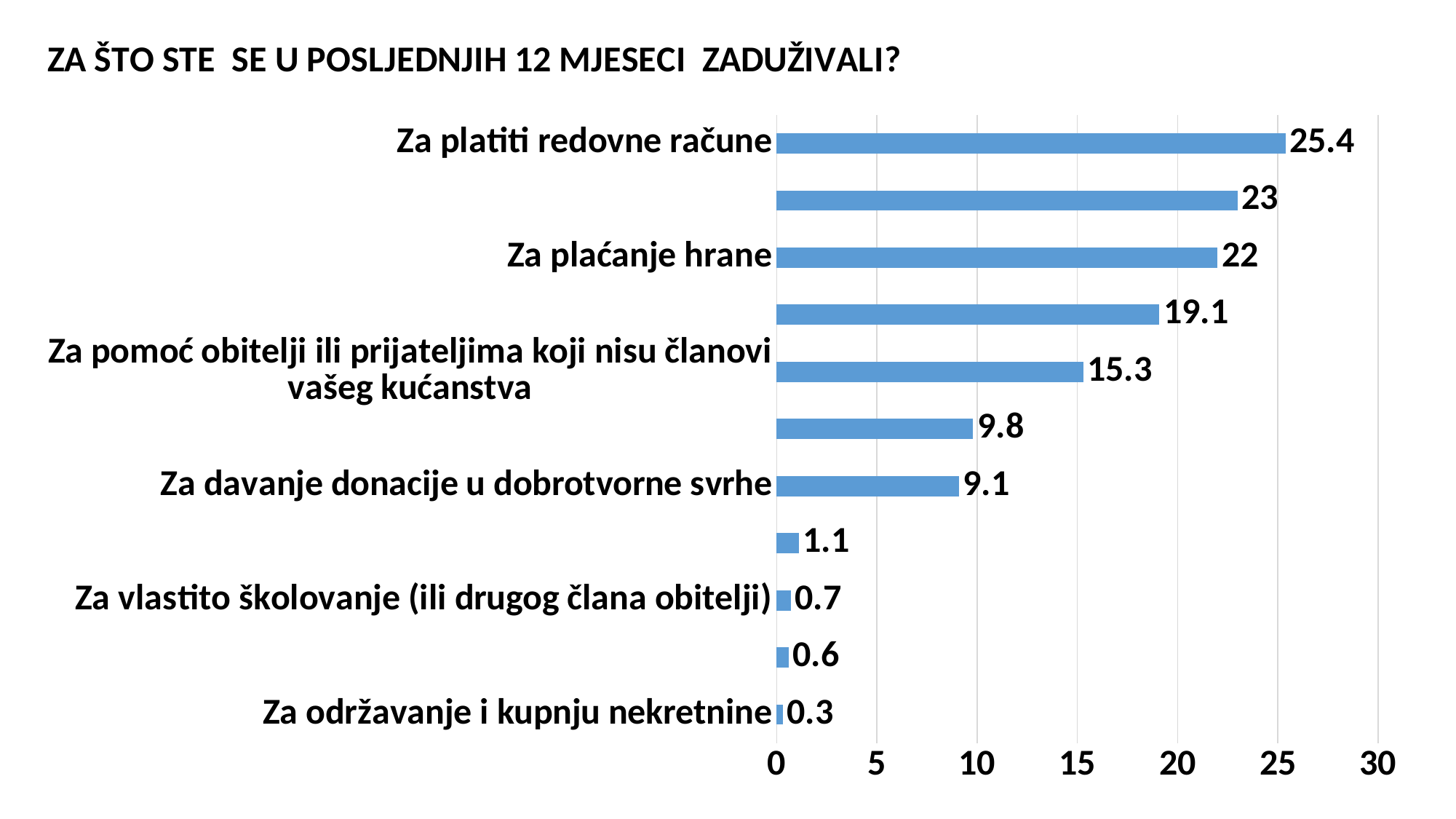
What is the value for "Za vlastito školovanje (ili drugog člana obitelji)"? 0.7 What is the value for "Za platiti redovne račune"? 25.4 Which is larger: the value for "Za plaćanje hrane" or for "Za davanje donacije u dobrotvorne svrhe"? Za plaćanje hrane Which labelled category has the lowest value? Za održavanje i kupnju nekretnine What is the value for "Za davanje donacije u dobrotvorne svrhe"? 9.1 What is the difference between the values for "Za platiti redovne račune" and "Za plaćanje hrane"? 3.4 How many bars are plotted in the chart? 11 What is the value for "Za plaćanje hrane"? 22 What is the title of the slide? ZA ŠTO STE SE U POSLJEDNJIH 12 MJESECI ZADUŽIVALI? Which labelled category has the highest value? Za platiti redovne račune What is the value for "Za pomoć obitelji ili prijateljima koji nisu članovi vašeg kućanstva"? 15.3 What kind of chart is shown on the slide? bar chart